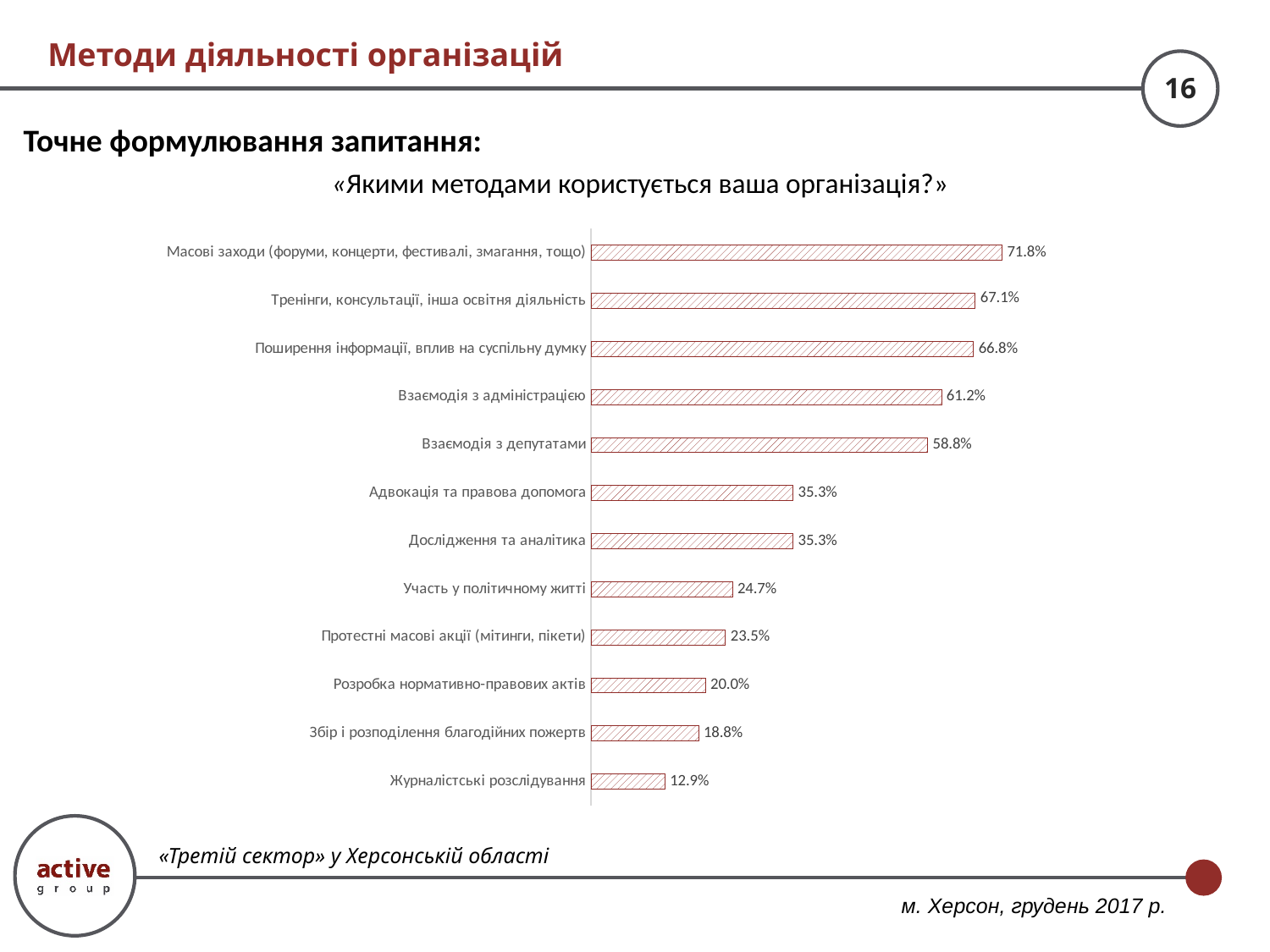
How many categories are shown in the chart? 12 What is the value for «Журналістські розслідування»? 12.9% What is the value for «Поширення інформації, вплив на суспільну думку»? 66.8% What is the difference between the values for «Тренінги, консультації, інша освітня діяльність» and «Взаємодія з адміністрацією»? 5.9% Which is larger: the value for «Участь у політичному житті» or for «Збір і розподілення благодійних пожертв»? Участь у політичному житті What is the value for «Розробка нормативно-правових актів»? 20.0% What is the value for «Масові заходи (форуми, концерти, фестивалі, змагання, тощо)»? 71.8% What kind of chart is shown on the slide? Bar chart What is the value for «Взаємодія з депутатами»? 58.8% What is the difference between the values for «Протестні масові акції (мітинги, пікети)» and «Журналістські розслідування»? 10.6% Which category has the highest value? Масові заходи (форуми, концерти, фестивалі, змагання, тощо) Which category has the lowest value? Журналістські розслідування